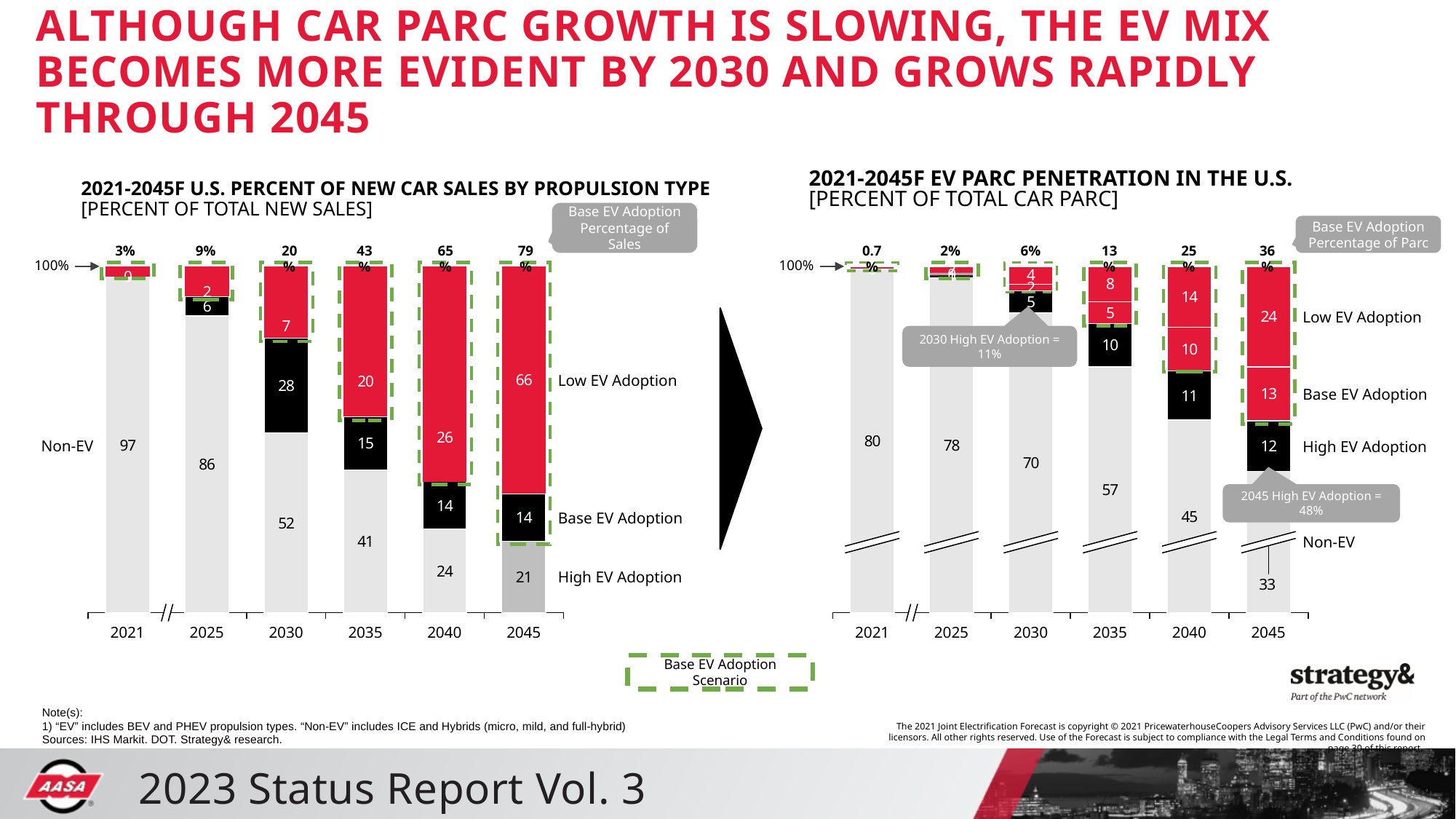
What kind of chart is the right chart (EV parc penetration in the U.S.)? stacked bar chart On the left chart (percent of new car sales by propulsion type), what is the Base EV Adoption Percentage of Sales shown above the 2035 bar? 43% On the right chart (EV parc penetration in the U.S.), does the Non-EV value rise or fall from 2021 to 2045? fall On the left chart (percent of new car sales by propulsion type), what is the Non-EV value for 2021? 97 On the right chart (EV parc penetration in the U.S.), what is the 2030 High EV Adoption value given in the callout? 11% On the left chart (percent of new car sales by propulsion type), what is the Base EV Adoption Percentage of Sales shown above the 2045 bar? 79% On the left chart (percent of new car sales by propulsion type), what is the difference between the Non-EV values for 2025 and 2030? 34 On the right chart (EV parc penetration in the U.S.), what is the 2045 High EV Adoption value given in the callout? 48% On the right chart (EV parc penetration in the U.S.), what is the Non-EV value for 2045? 33 On the right chart (EV parc penetration in the U.S.), what is the Base EV Adoption Percentage of Parc shown above the 2040 bar? 25% On the left chart (percent of new car sales by propulsion type), which year has the lowest Non-EV value? 2045 On the left chart (percent of new car sales by propulsion type), how many years are shown on the x axis? 6